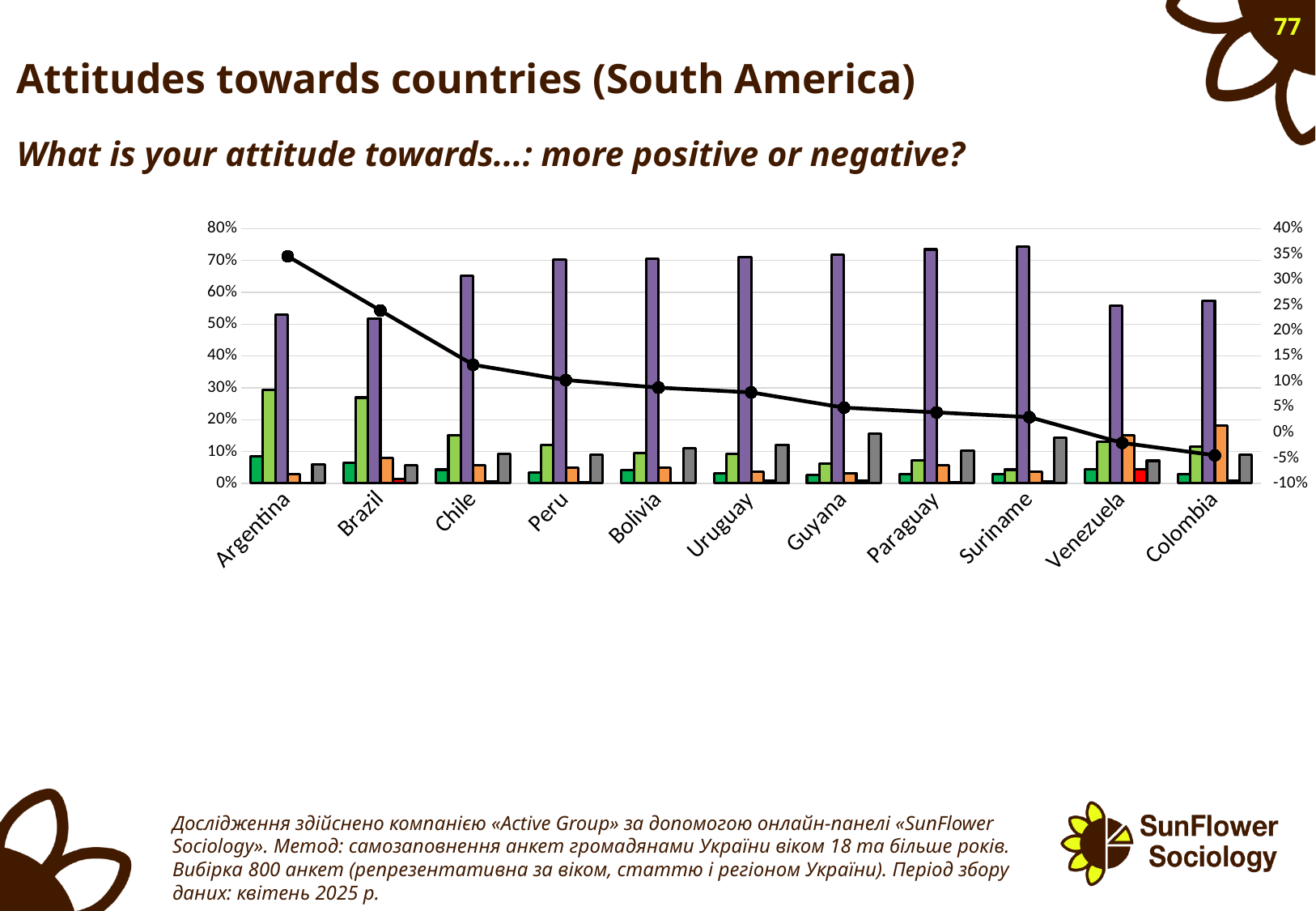
For which country is the black line at its highest point? Argentina Is the black line value for Colombia greater or less than 0% on the right axis? less How many countries are shown on the x axis of the chart? 11 Is the black line value for Chile greater or less than 20% on the right axis? less Is the purple bar for Suriname greater or less than 70% on the left axis? greater Does the black line rise or fall from Argentina to Colombia along the x axis? It falls What is the title of the slide containing the chart? Attitudes towards countries (South America) What kind of chart is shown on the slide? A bar chart combined with a line Which is larger, the purple bar for Suriname or the purple bar for Venezuela? Suriname For which country is the black line at its lowest point? Colombia